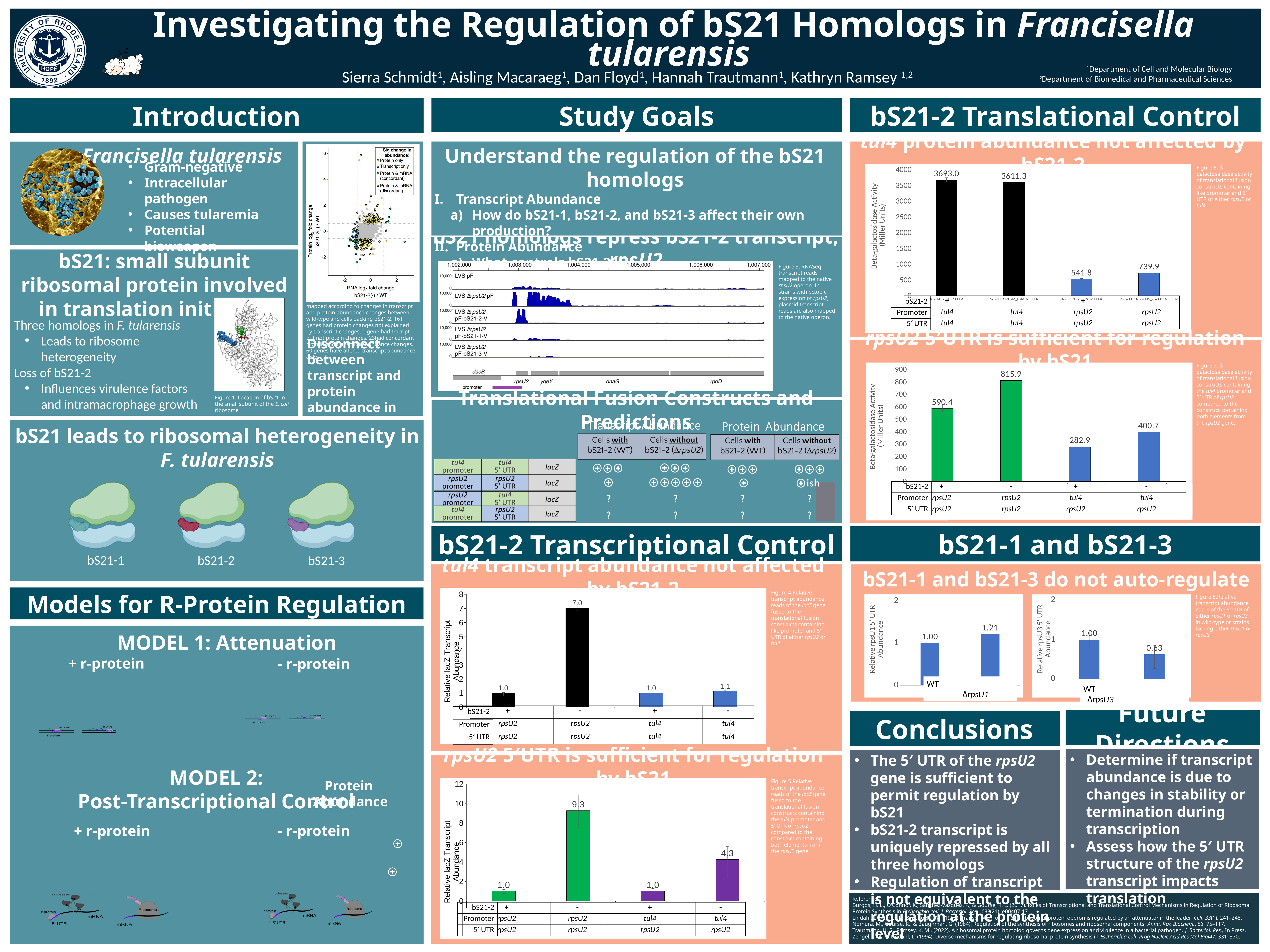
In the right chart of the 'bS21-1 and bS21-3' section (Relative rpsU3 5' UTR Abundance), which is larger, WT or ΔrpsU3? WT In the top chart of the 'bS21-2 Translational Control' section (axis 0–4000), what is the lowest value shown? 541.8 In the second chart of the 'bS21-2 Translational Control' section (Beta-galactosidase Activity, axis 0–900), what is the value of the bar for the tul4 promoter with rpsU2 5' UTR in cells with bS21-2 (bS21-2 '+')? 282.9 In the bottom chart of the 'bS21-2 Transcriptional Control' section (axis 0–12), what is the value of the bar for the tul4 promoter with rpsU2 5' UTR in cells lacking bS21-2 (bS21-2 '-')? 4.3 In the top chart of the 'bS21-2 Transcriptional Control' section (Relative lacZ Transcript Abundance, axis 0–8), what is the value of the bar for the rpsU2 promoter with rpsU2 5' UTR in cells lacking bS21-2 (bS21-2 '-')? 7.0 In the top chart of the 'bS21-2 Translational Control' section (Beta-galactosidase Activity, axis 0–4000), what is the value of the first bar (tul4 promoter, tul4 5' UTR, bS21-2 '+')? 3693.0 In the top chart of the 'bS21-2 Transcriptional Control' section (axis 0–8), which bar is the highest? rpsU2 promoter, rpsU2 5' UTR, bS21-2 '-' (7.0) In the second chart of the 'bS21-2 Translational Control' section (axis 0–900), what is the difference between the two rpsU2 promoter bars (815.9 and 590.4)? 225.5 In the left chart of the 'bS21-1 and bS21-3' section (Relative rpsU1 5' UTR Abundance), what is the value for ΔrpsU1? 1.21 In the bottom chart of the 'bS21-2 Transcriptional Control' section (axis 0–12), what is the difference between the rpsU2 promoter bS21-2 '-' bar (9.3) and the tul4 promoter bS21-2 '-' bar (4.3)? 5.0 In the top chart of the 'bS21-2 Translational Control' section (axis 0–4000), how many bars are plotted? 4 What type of chart is used in the 'bS21-2 Transcriptional Control' section? Bar chart